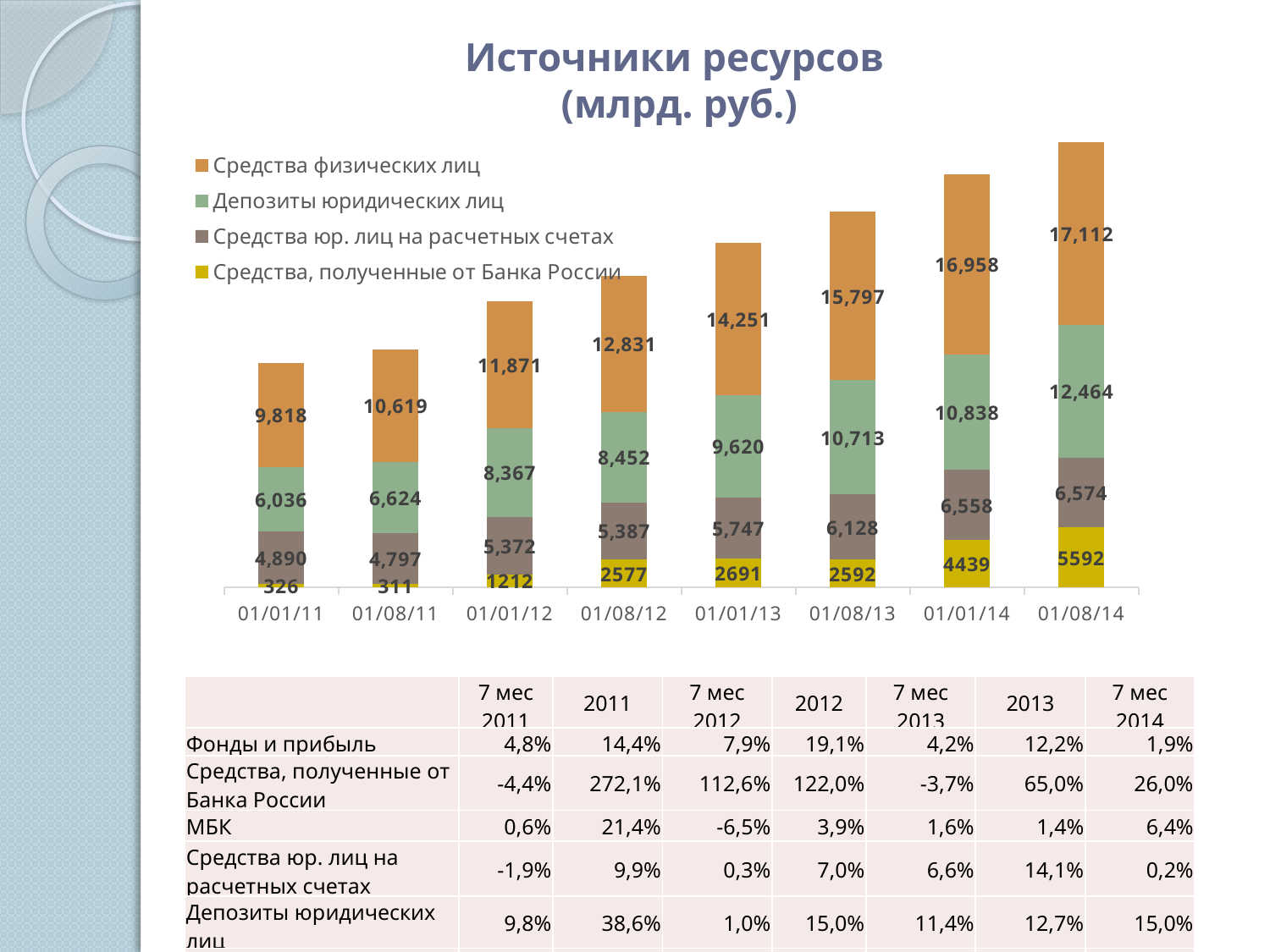
What is the value of Средства, полученные от Банка России at 01/01/12? 1212 What is the value of Средства юр. лиц на расчетных счетах at 01/08/13? 6,128 What is the value of Средства физических лиц at 01/08/14? 17,112 How many dates are shown along the x axis of the chart? 8 What is the value of Депозиты юридических лиц at 01/01/13? 9,620 At which date is Депозиты юридических лиц highest? 01/08/14 What type of chart is shown on the slide? stacked bar chart Does Средства физических лиц rise or fall across the dates on the x axis? rise At which date is Средства, полученные от Банка России lowest? 01/08/11 By how much did Средства физических лиц increase from 01/01/11 to 01/08/14? 7,294 How many series does the chart legend list? 4 Which is larger: Средства юр. лиц на расчетных счетах at 01/01/11 or at 01/08/11? 01/01/11